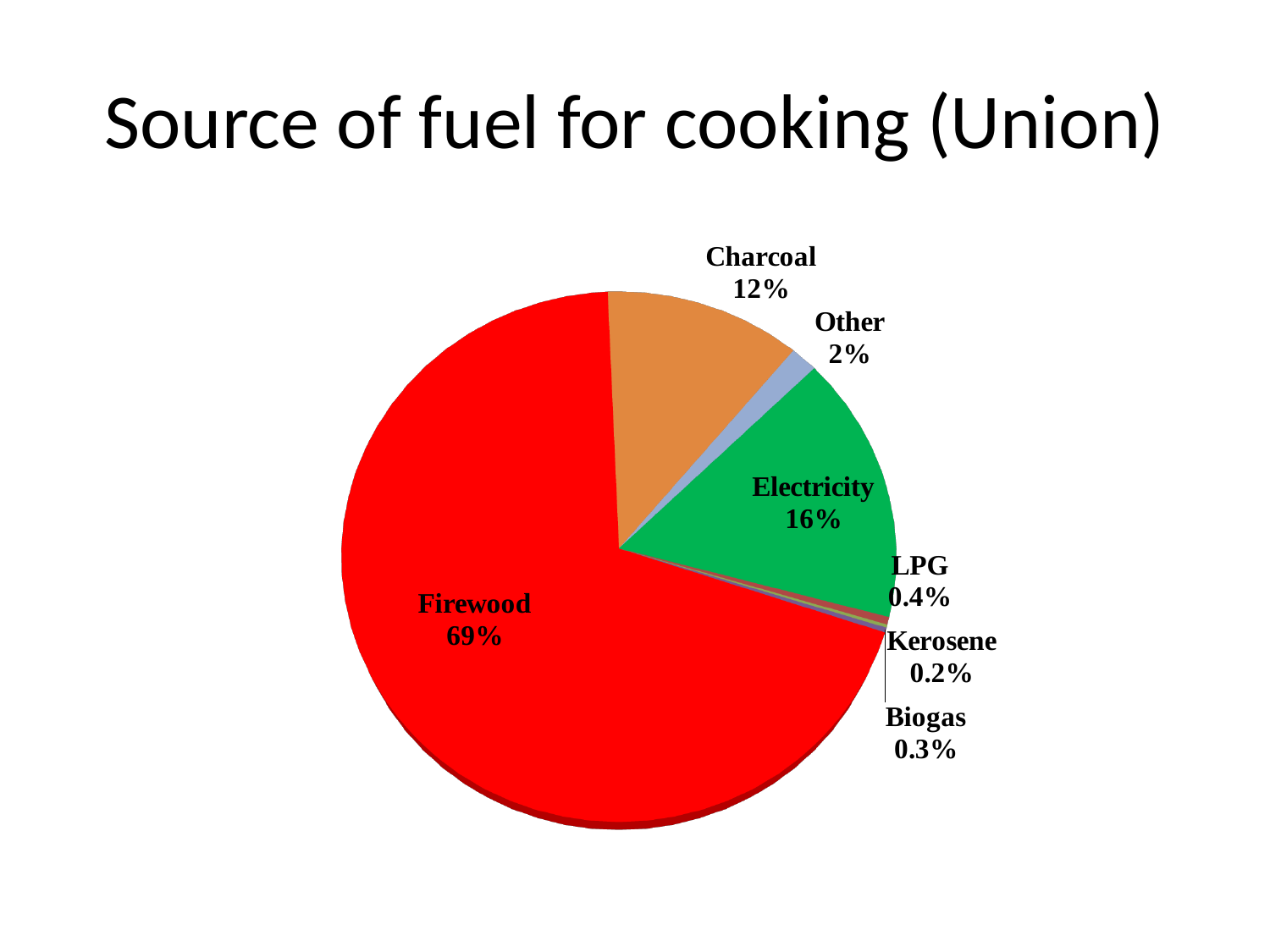
How many categories are shown in the pie chart? 7 What is the value for Biogas? 0.3% What is the value for Charcoal? 12% What is the value for Electricity? 16% What kind of chart is shown on the slide? Pie chart Which is larger, the share for Other or the share for LPG? Other Which source of fuel has the smallest share? Kerosene What is the value for LPG? 0.4% What is the value for Kerosene? 0.2% Which source of fuel has the largest share? Firewood What share of the pie does Firewood account for? 69% What is the difference between the Electricity and Charcoal shares? 4%